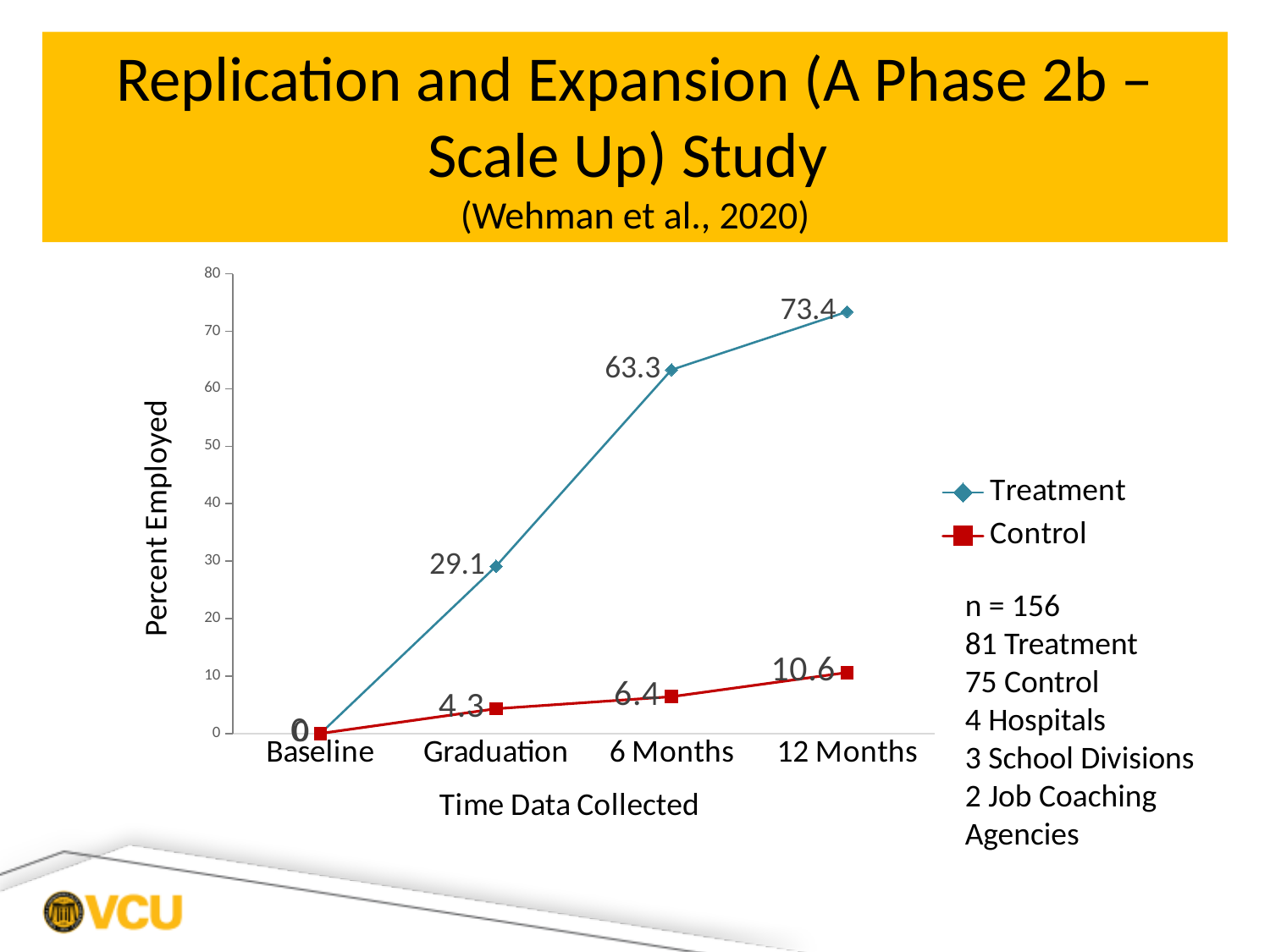
Which group has the higher percent employed at 6 Months, Treatment or Control? Treatment What is the percent employed for the Control group at 12 Months? 10.6 How many time points are plotted on the x axis? 4 Does the Control group's percent employed rise or fall from Baseline to 12 Months? rise What is the percent employed for the Treatment group at 12 Months? 73.4 How many series does the legend list? 2 What is the difference between the Treatment group's percent employed at 6 Months and at Graduation? 34.2 What type of chart is shown on the slide? line chart What is the difference between the Treatment and Control percent employed at 12 Months? 62.8 What is the percent employed for the Control group at Graduation? 4.3 At which time point is the Treatment group's percent employed highest? 12 Months What is the percent employed for the Treatment group at 6 Months? 63.3